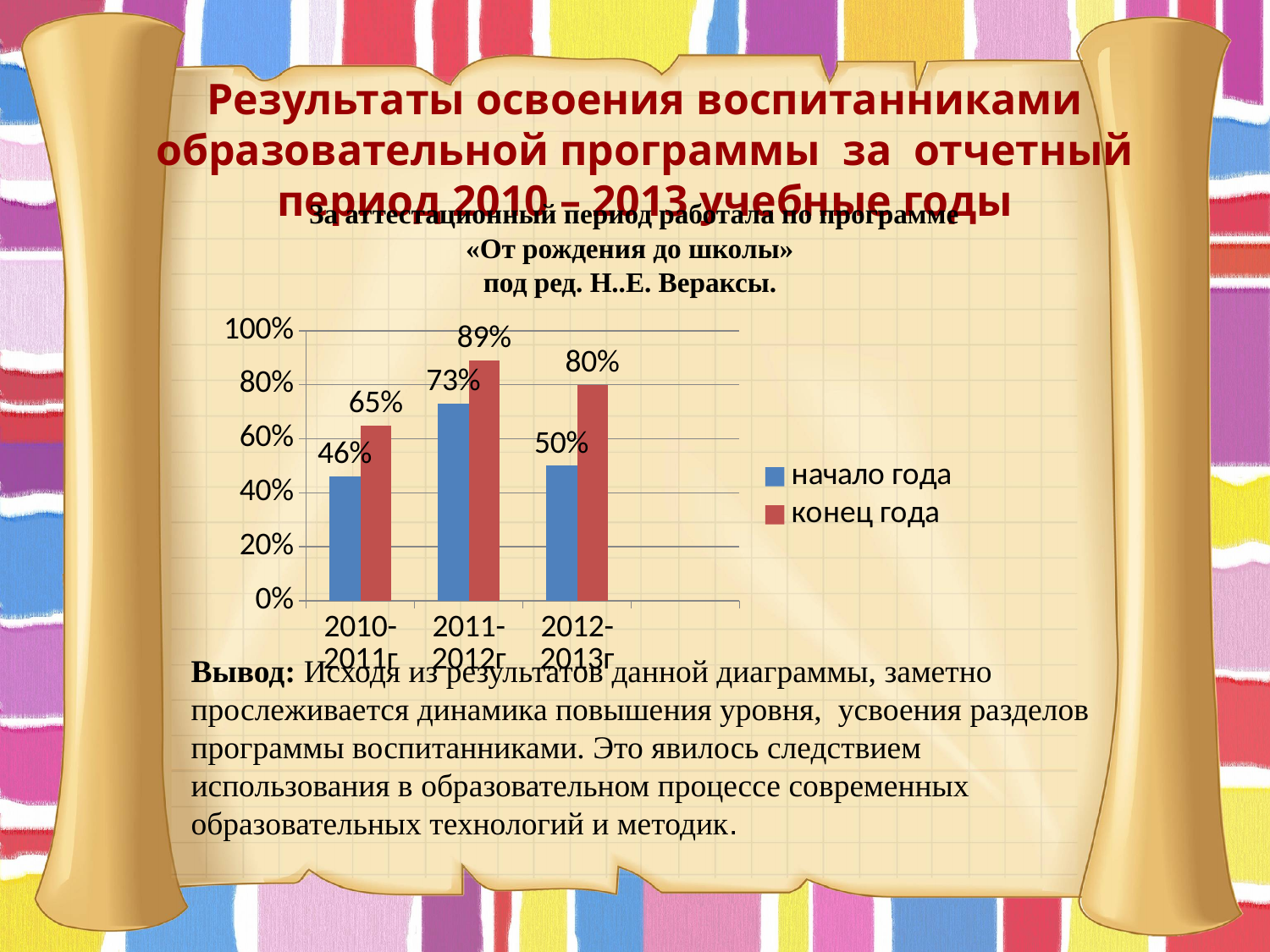
Which year has the highest value for конец года? 2011-2012г What is the value for конец года in 2011-2012г? 89% How many year categories are shown on the x axis? 3 Which year has the lowest value for начало года? 2010-2011г What kind of chart is shown on the slide? bar chart What is the value for начало года in 2012-2013г? 50% How many series does the legend list? 2 Which is larger: начало года in 2011-2012г or конец года in 2010-2011г? начало года in 2011-2012г What is the difference between конец года and начало года in 2012-2013г? 30% What is the difference between конец года and начало года in 2010-2011г? 19% What is the value for начало года in 2010-2011г? 46% What is the value for конец года in 2012-2013г? 80%